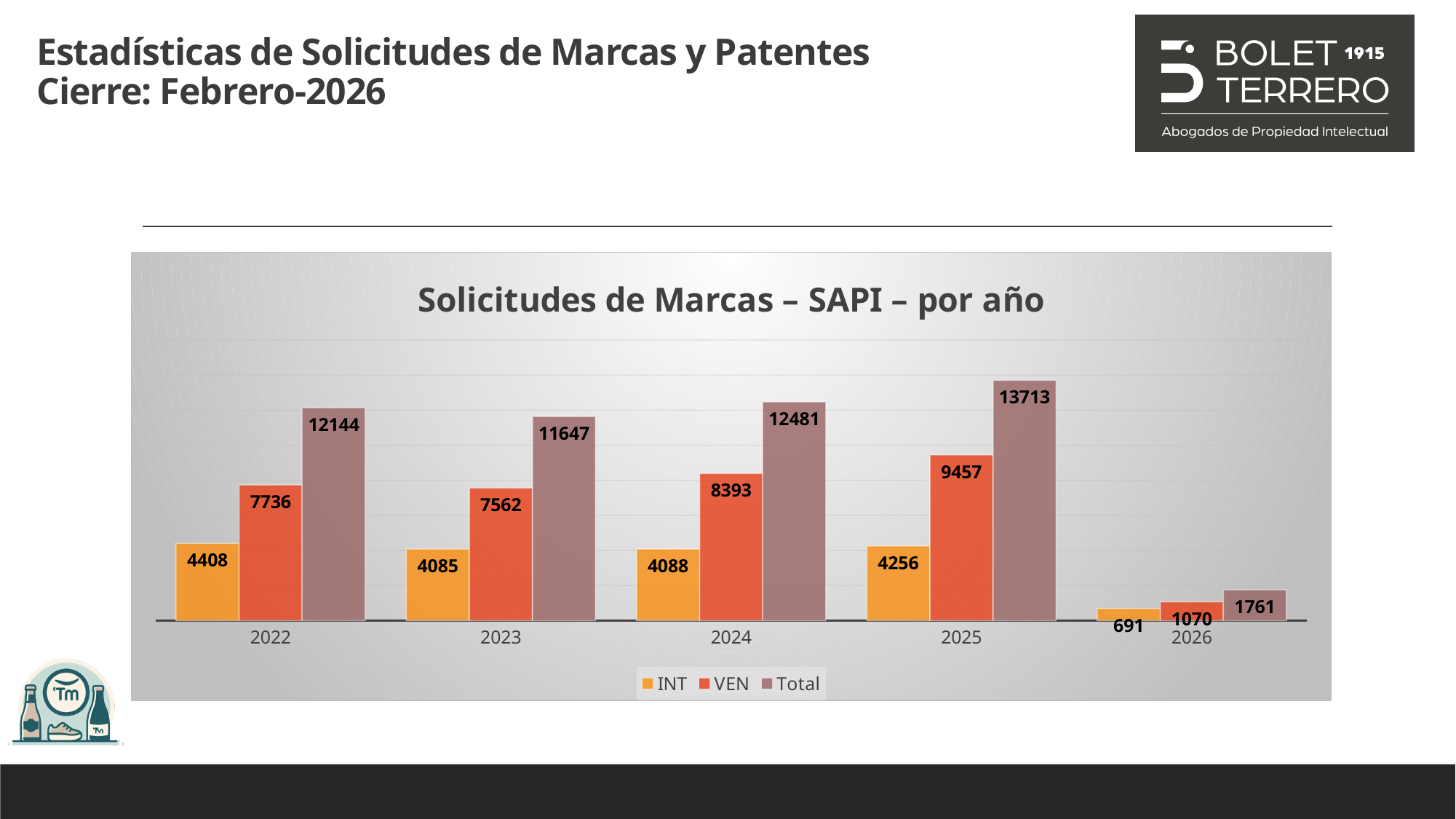
What is the VEN value for 2026? 1070 What is the difference between the VEN values for 2025 and 2024? 1064 What is the VEN value for 2025? 9457 What kind of chart is shown on the slide? Bar chart What is the INT value for 2022? 4408 Which is larger, the INT value for 2022 or the INT value for 2023? 2022 What is the title of the chart? Solicitudes de Marcas – SAPI – por año What is the Total value for 2024? 12481 How many years are shown on the x axis? 5 Which year has the lowest INT value? 2026 How many series does the legend list? 3 Which year has the highest Total value? 2025